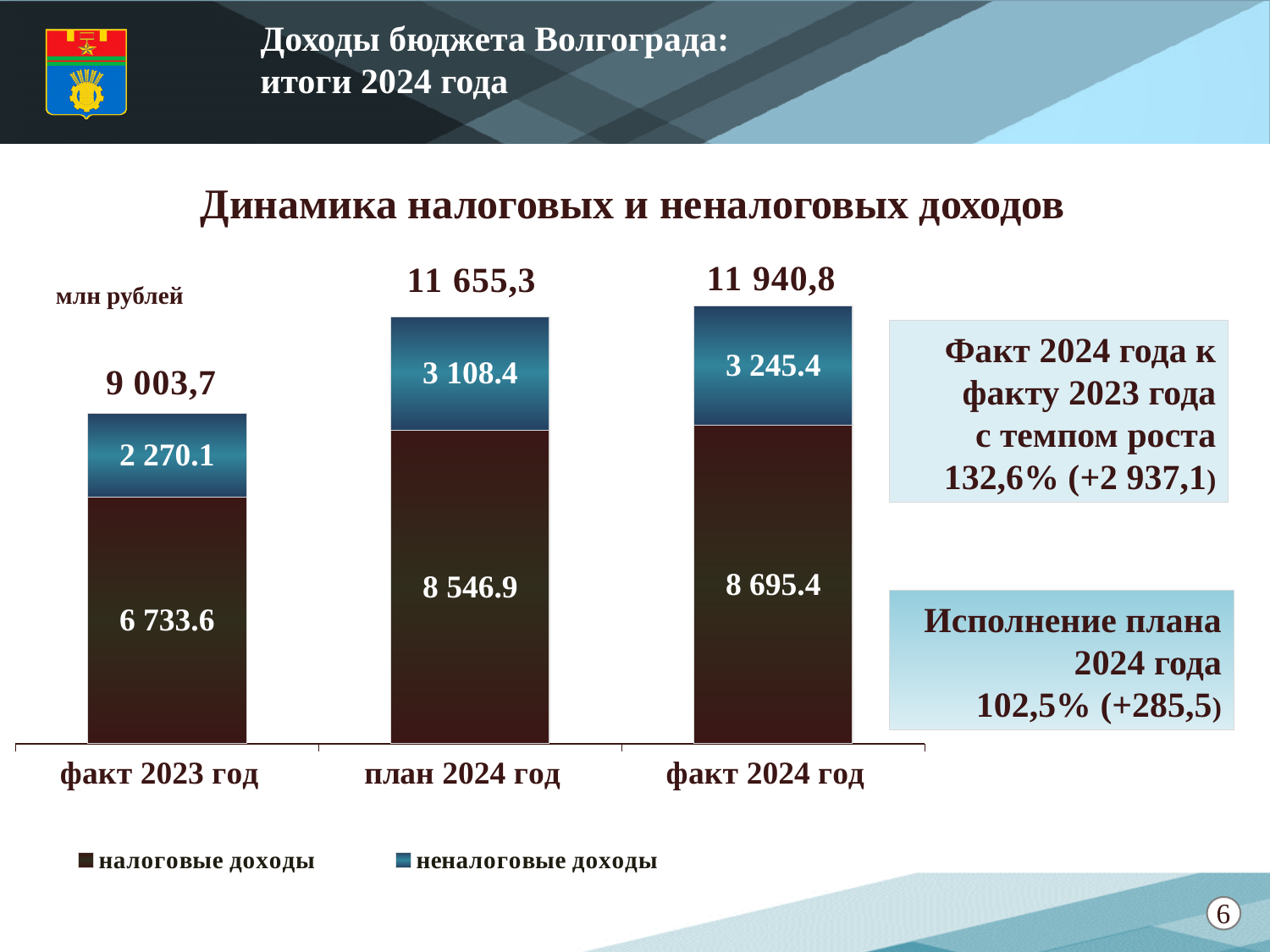
What is the value of неналоговые доходы for план 2024 год? 3 108.4 How many categories are shown on the x axis of the chart? 3 Which category has the lowest value of налоговые доходы? факт 2023 год What is the value of неналоговые доходы for факт 2024 год? 3 245.4 What is the total of the stacked bar for факт 2023 год? 9 003,7 What is the total of the stacked bar for факт 2024 год? 11 940,8 What type of chart is shown on the slide? stacked bar chart What is the value of налоговые доходы for факт 2023 год? 6 733.6 Which category has the highest total? факт 2024 год Which is larger: неналоговые доходы for факт 2023 год or for план 2024 год? план 2024 год What is the difference between налоговые доходы for факт 2024 год and план 2024 год? 148.5 How many series does the legend list? 2